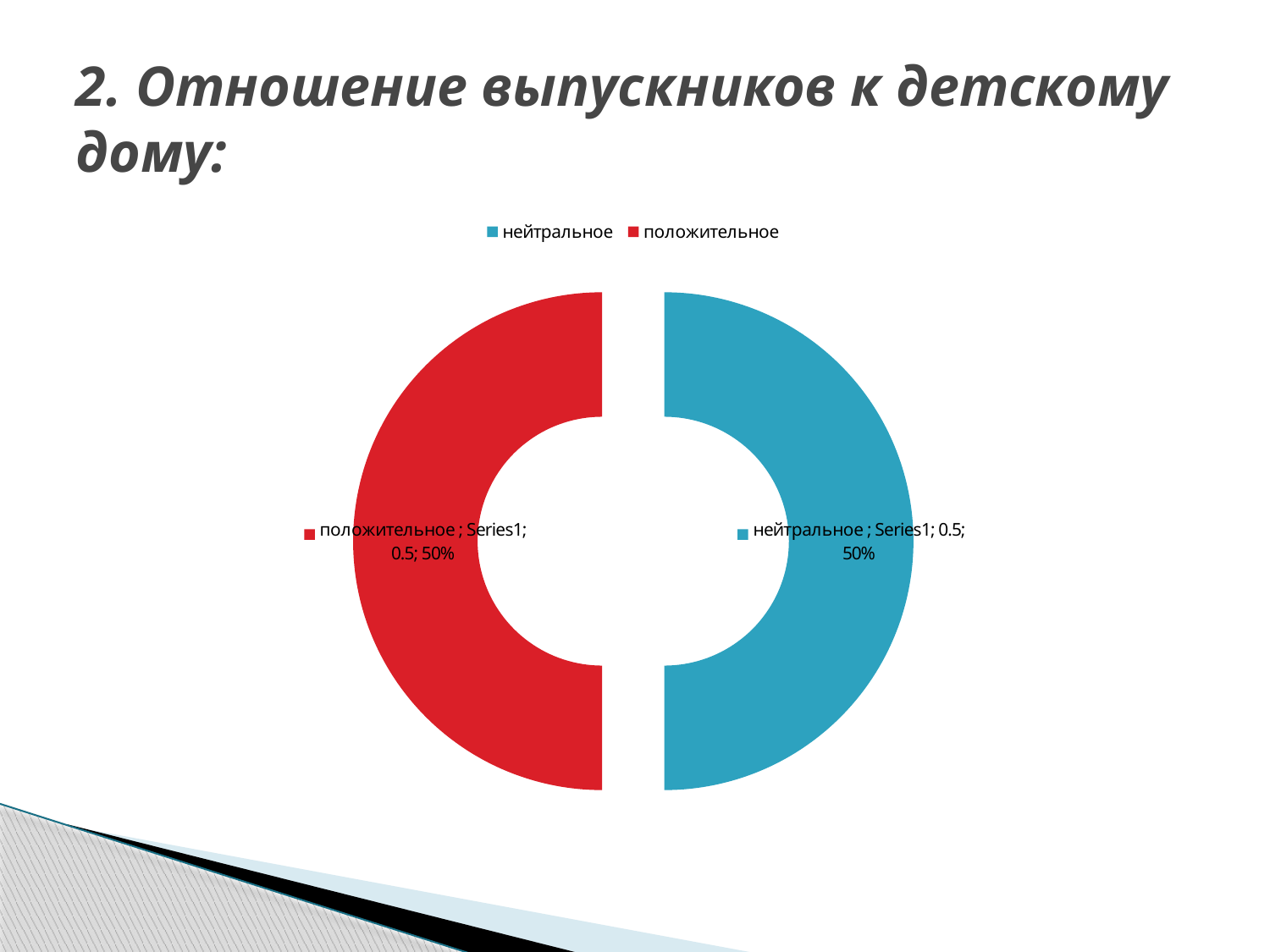
What kind of chart is shown on the slide? doughnut chart How many slices does the chart have? 2 What value is printed in the data label for "нейтральное"? 0.5 What is the difference between the shares of "нейтральное" and "положительное"? 0% What value is printed in the data label for "положительное"? 0.5 What is the total of the two slice values shown in the data labels? 1 Which colour is used for the "положительное" slice? red What share of the chart does the "положительное" slice represent? 50% How many entries does the legend list? 2 What share of the chart does the "нейтральное" slice represent? 50% Which colour is used for the "нейтральное" slice? blue